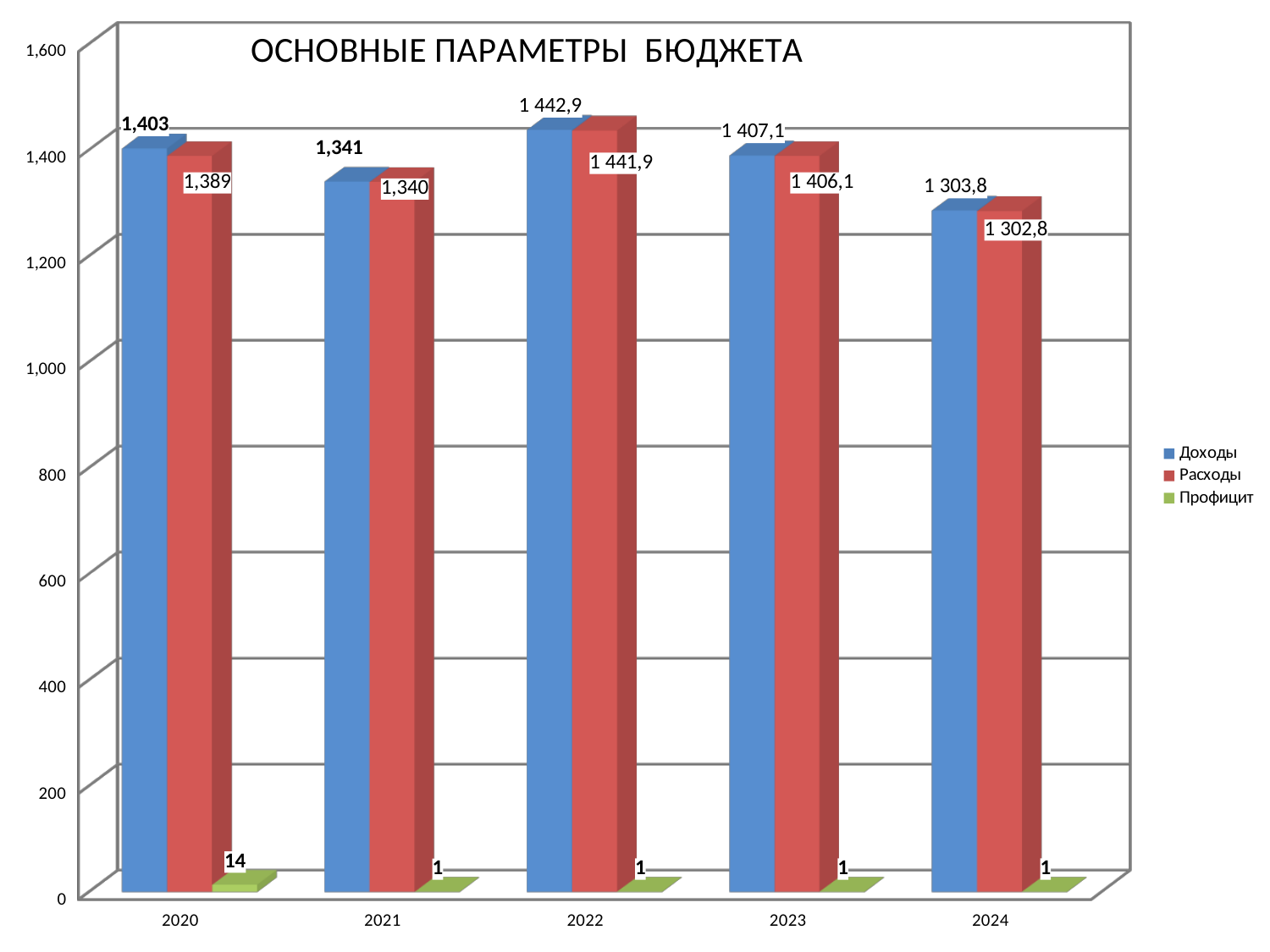
What is the value of Доходы for 2024? 1 303,8 What is the difference between Доходы and Расходы in 2020? 14 Which is larger: Доходы in 2022 or Доходы in 2023? Доходы in 2022 How many series does the legend list? 3 How many years are shown on the x axis? 5 What kind of chart is shown on the slide? Bar chart Is the value of Расходы for 2024 greater or less than 1,400? less In which year is Доходы the highest? 2022 In which year is Доходы the lowest? 2024 What is the value of Профицит for 2020? 14 What is the value of Доходы for 2020? 1,403 What is the value of Расходы for 2022? 1 441,9